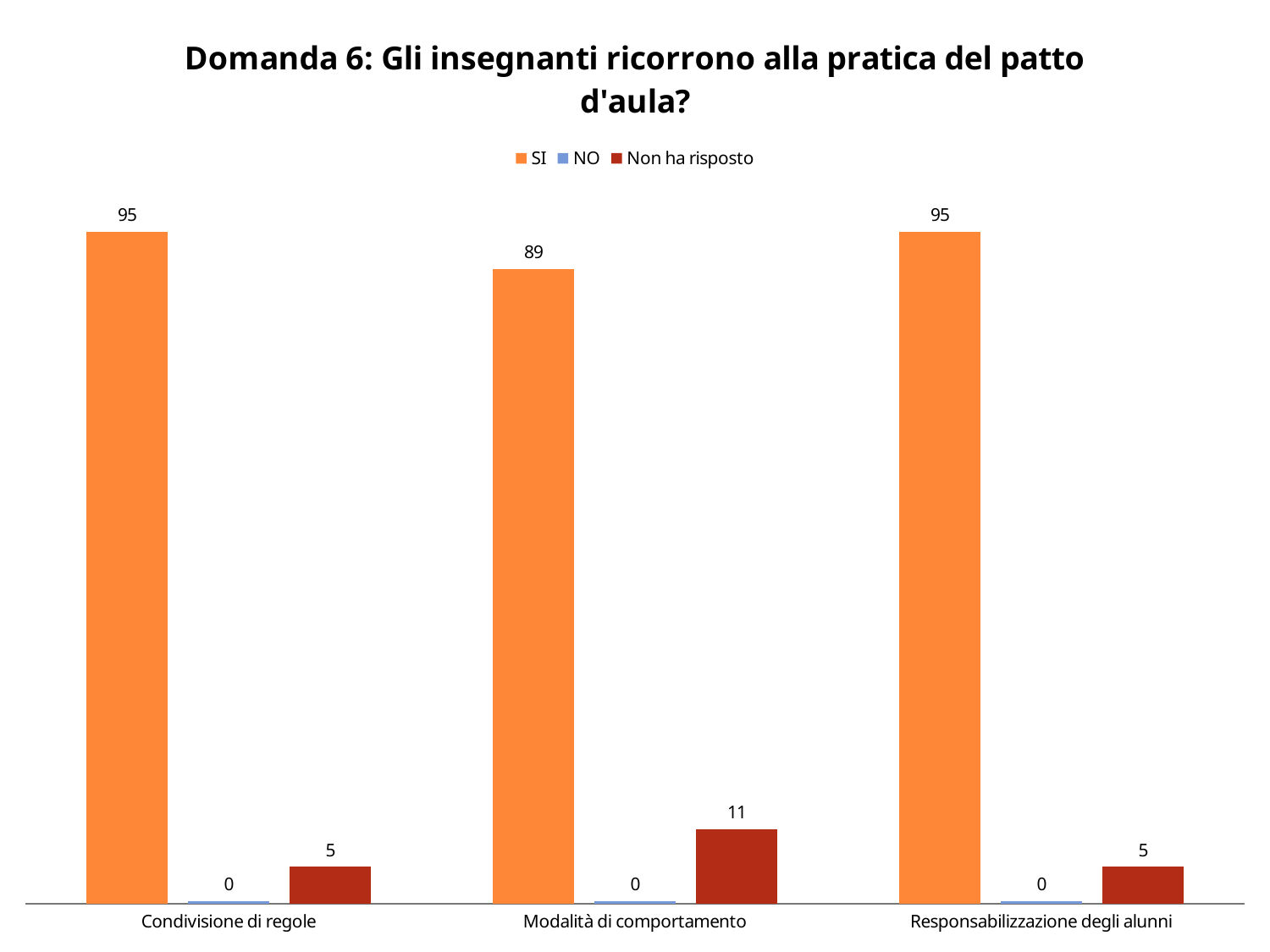
What kind of chart is this? bar chart Which category has the highest Non ha risposto value? Modalità di comportamento What is the Non ha risposto value for Modalità di comportamento? 11 How many categories are shown on the x axis? 3 What is the SI value for Modalità di comportamento? 89 How many series does the legend list? 3 What colour are the SI bars? orange What is the SI value for Condivisione di regole? 95 What is the NO value for Responsabilizzazione degli alunni? 0 Which category has the lowest SI value? Modalità di comportamento Which is larger: the Non ha risposto value for Modalità di comportamento or for Responsabilizzazione degli alunni? Modalità di comportamento What is the difference between the SI values for Condivisione di regole and Modalità di comportamento? 6